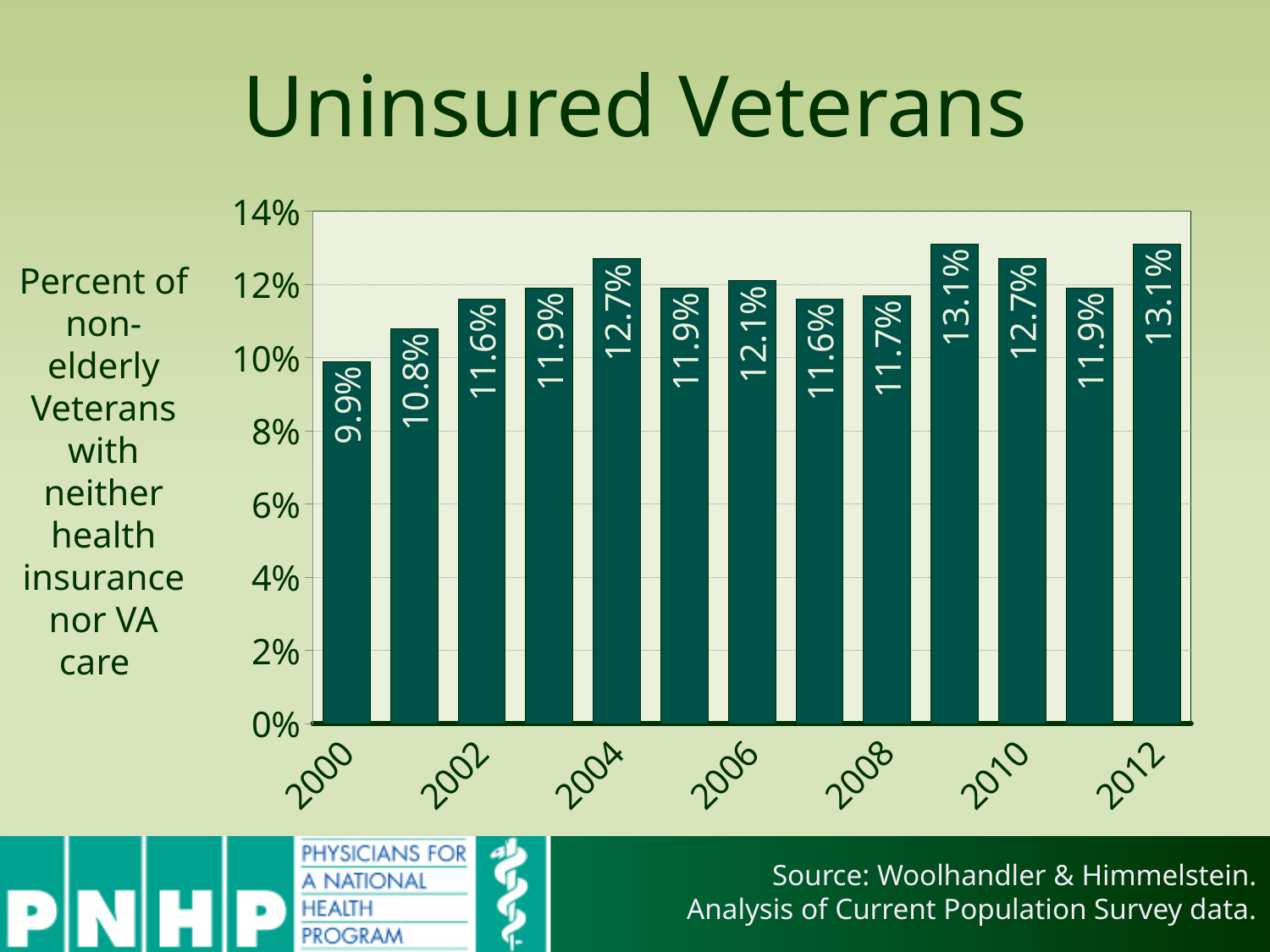
What is the value for 2000? 9.9% What is the value for 2004? 12.7% What is the highest value shown on the chart? 13.1% Which is larger, the value for 2006 or the value for 2008? 2006 What is the difference between the values for 2012 and 2000? 3.2 percentage points Which year has the lowest value? 2000 What kind of chart is this? bar chart Is the value for 2000 greater or less than 10%? less Overall, do the values rise or fall from 2000 to 2012? rise What is the value for 2008? 11.7% What is the value for 2012? 13.1% How many bars are shown on the chart? 13